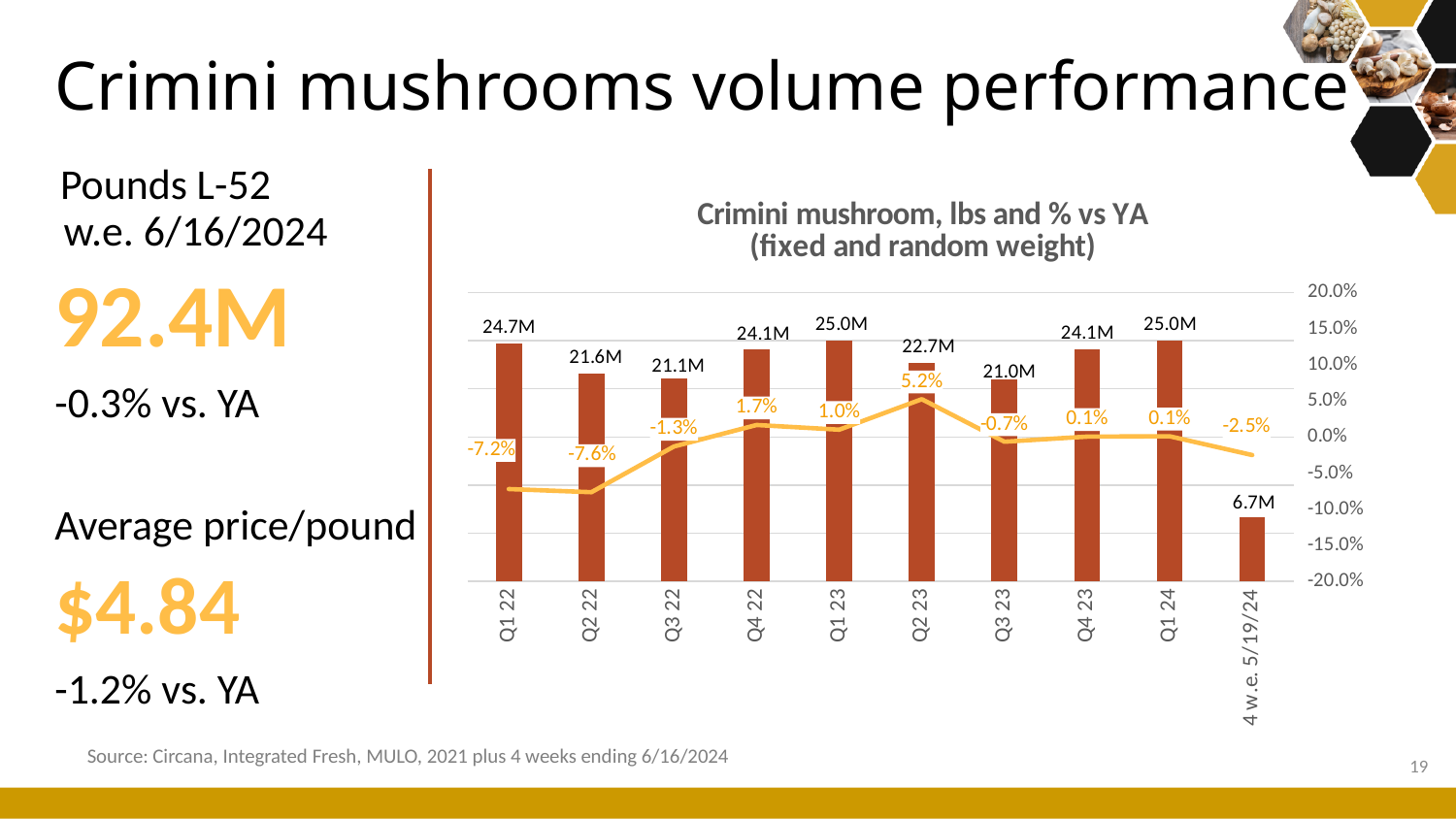
Which period has the lowest pounds value? 4 w.e. 5/19/24 Which period has the highest % vs YA value? Q2 23 What is the % vs YA value shown for Q4 23? 0.1% Does the % vs YA line rise or fall from Q1 22 to Q4 22? Rise Which period has the lowest % vs YA value? Q2 22 What is the pounds value shown for Q1 22? 24.7M What is the % vs YA value shown for Q2 23? 5.2% Which period has the larger pounds value, Q3 22 or Q4 22? Q4 22 What is the pounds value shown for the 4 w.e. 5/19/24 period? 6.7M What kind of chart is shown? Bar chart with a line What is the difference in pounds between Q1 22 and Q2 22? 3.1M How many periods are shown on the x axis? 10